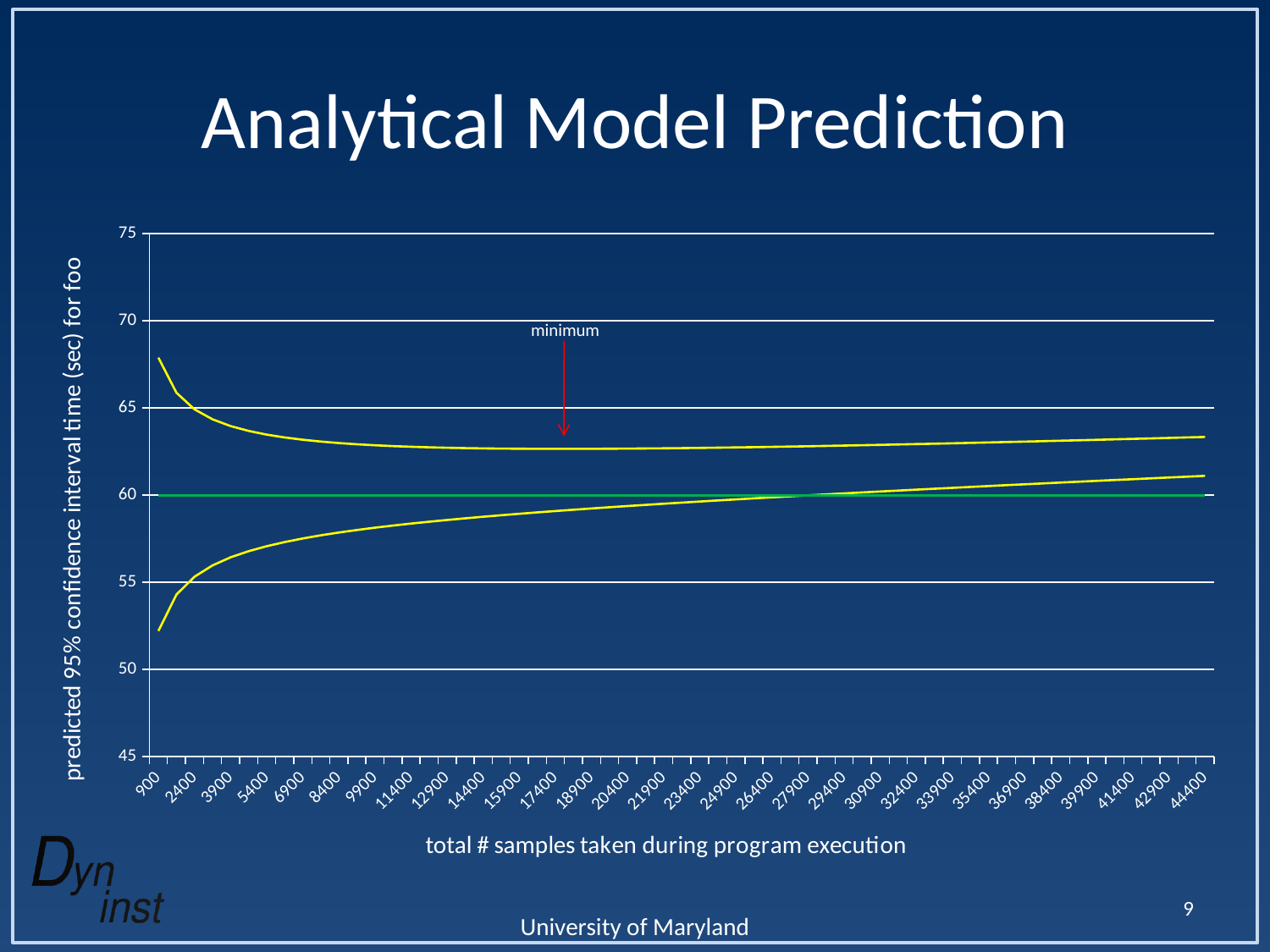
Is the value of the lower yellow line at 44400 samples greater or less than 60? greater At 900 samples, which is larger: the upper yellow line or the lower yellow line? the upper yellow line How many x-axis categories (sample counts) are shown along the x axis? 30 Is the value of the lower yellow line at 900 samples greater or less than 55? less Is the value of the upper yellow line at 900 samples greater or less than 65? greater Does the upper yellow line rise or fall between 900 and 17400 samples? fall Does the lower yellow line rise or fall as the number of samples increases along the x axis? rise What is the label of the x axis? total # samples taken during program execution What kind of chart is shown on the slide? line chart What is the title of the chart on the slide? Analytical Model Prediction What is the highest value shown on the y axis? 75